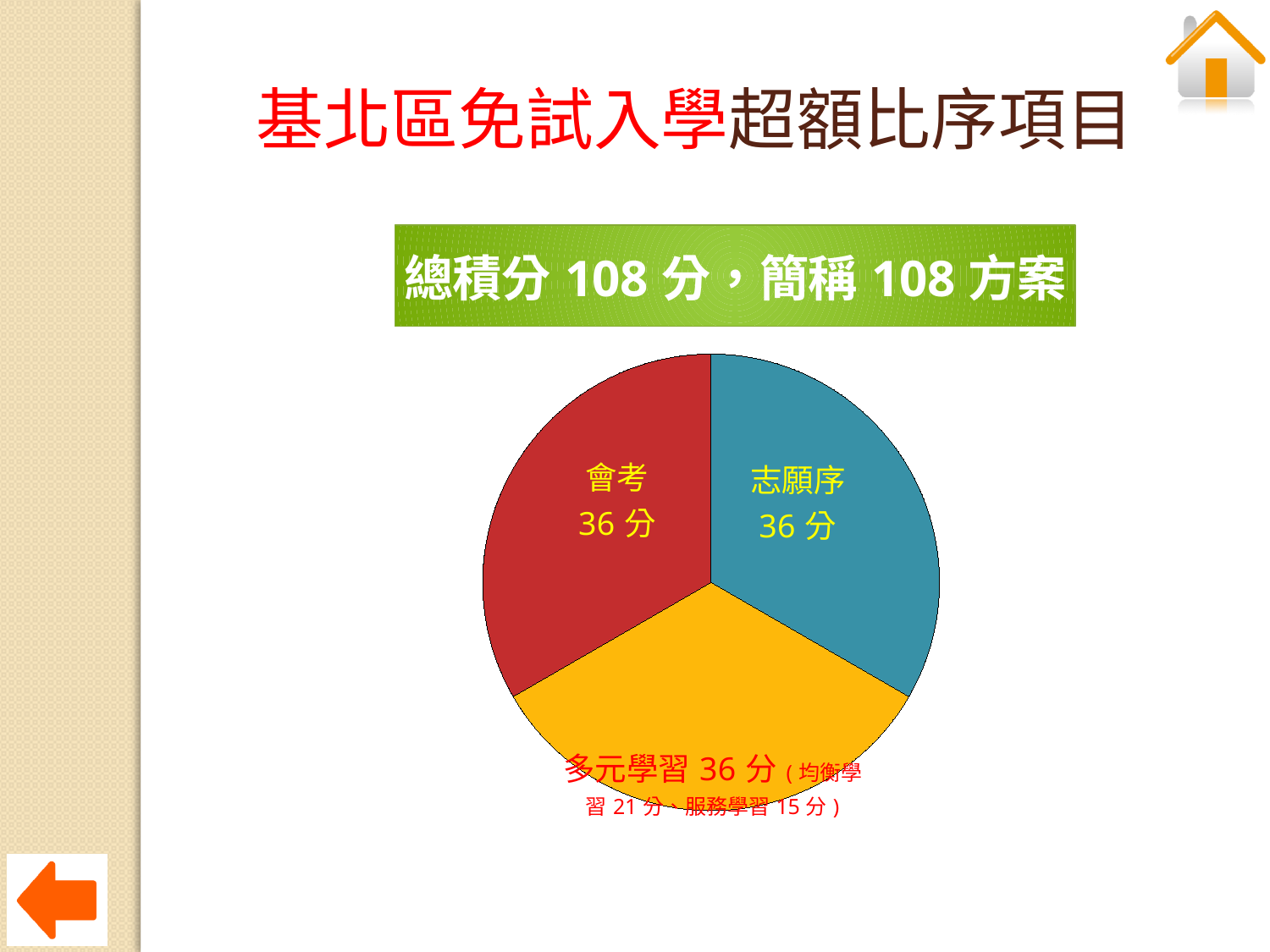
What is the value shown for 志願序 in the pie chart? 36 分 What colour is the 多元學習 slice in the pie chart? yellow What is the value shown for 會考 in the pie chart? 36 分 What is the difference between the values for 會考 and 志願序? 0 分 How many slices does the pie chart have? 3 According to the label on the slide, how many points does 均衡學習 contribute within 多元學習? 21 分 What colour is the 會考 slice in the pie chart? red What kind of chart is shown on the slide? pie chart What share of the total does the 志願序 slice represent? 33.3% According to the label on the slide, how many points does 服務學習 contribute within 多元學習? 15 分 What is the total of all three slices in the pie chart? 108 分 What is the value shown for 多元學習 in the pie chart? 36 分